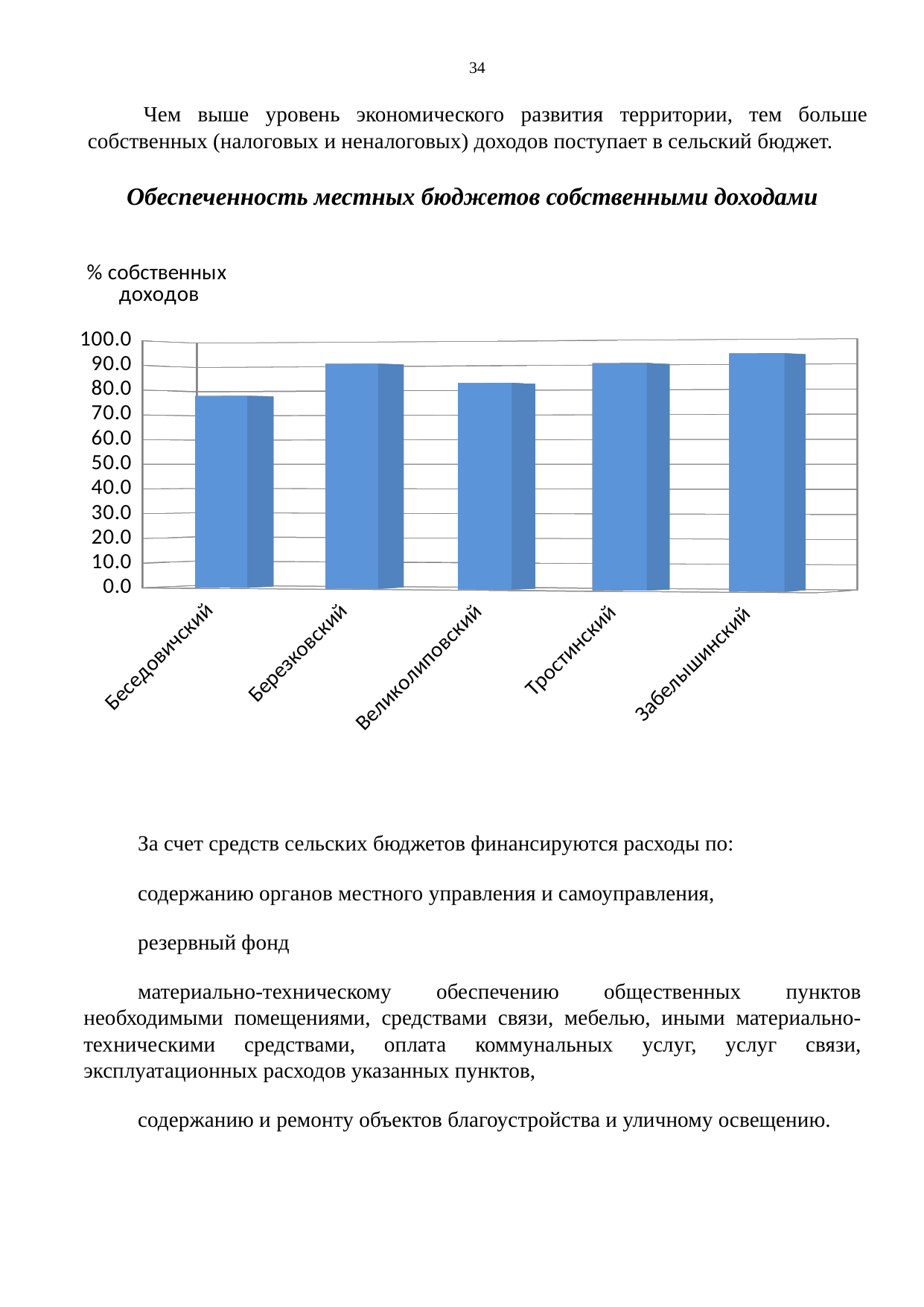
How many categories (settlements) are shown on the x axis of the chart? 5 What is the title of the chart? % собственных доходов Is the value for Забельшинский greater or less than 90.0? greater What kind of chart is shown on the slide? bar chart Is the value for Великолиповский greater or less than 90.0? less Is the value for Беседовичский greater or less than 80.0? less Which has the larger value, Беседовичский or Великолиповский? Великолиповский Which category has the lowest value in the chart? Беседовичский Which category has the highest value in the chart? Забелышинский